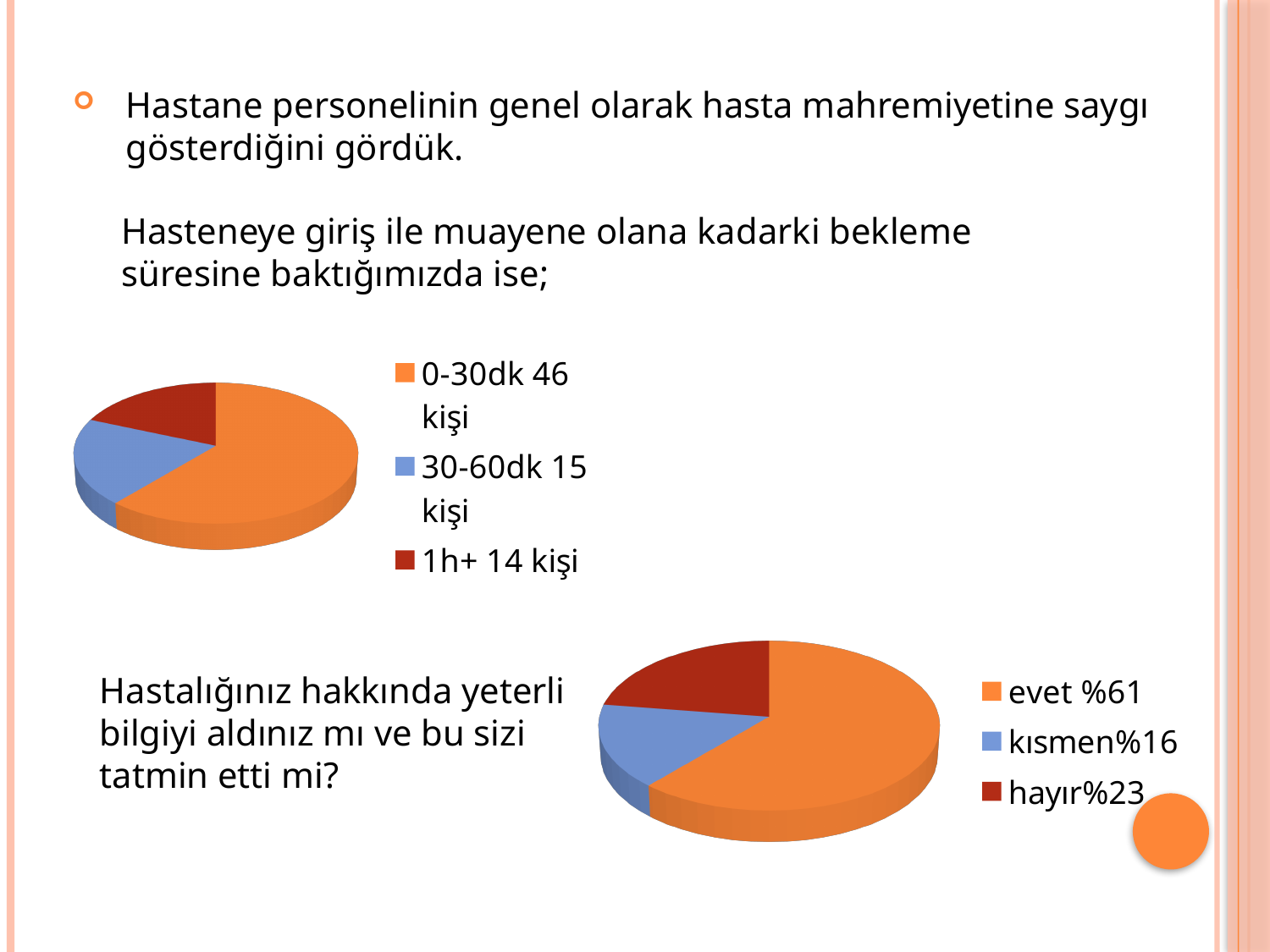
In the upper pie chart (waiting time), how many people waited more than 1 hour (1h+)? 14 kişi In the upper pie chart (waiting time), how many people waited 30-60 minutes (30-60dk)? 15 kişi In the lower pie chart (Hastalığınız hakkında yeterli bilgiyi aldınız mı), which answer has the smallest share? kısmen In the upper pie chart (waiting time), how many more people waited 0-30dk than 30-60dk? 31 What kind of chart is the upper chart on the slide (the waiting-time chart)? pie chart In the lower pie chart (Hastalığınız hakkında yeterli bilgiyi aldınız mı), what colour is the 'evet' slice? orange In the upper pie chart (waiting time), which waiting-time category has the most people? 0-30dk In the lower pie chart (Hastalığınız hakkında yeterli bilgiyi aldınız mı), what share answered 'hayır'? %23 In the lower pie chart (Hastalığınız hakkında yeterli bilgiyi aldınız mı), what share answered 'evet'? %61 In the upper pie chart (waiting time), how many people waited 0-30 minutes (0-30dk)? 46 kişi In the lower pie chart (Hastalığınız hakkında yeterli bilgiyi aldınız mı), which is larger: the share for 'hayır' or for 'kısmen'? hayır In the upper pie chart (waiting time), how many categories does the legend list? 3